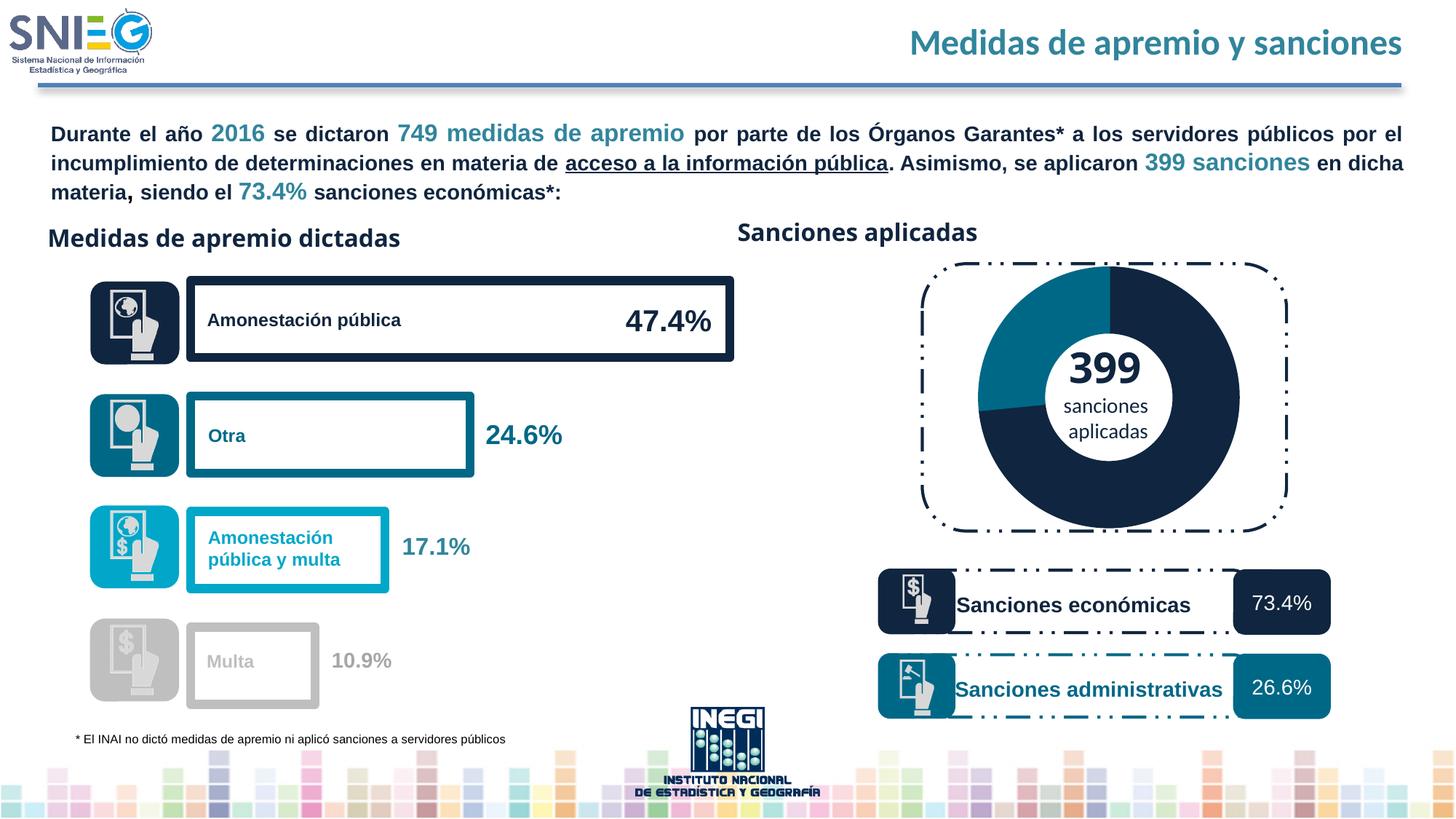
What kind of chart is 'Medidas de apremio dictadas'? Bar chart In the 'Medidas de apremio dictadas' chart, what is the difference between Amonestación pública and Otra? 22.8% In the 'Medidas de apremio dictadas' chart, what is the value for Multa? 10.9% How many categories does the 'Medidas de apremio dictadas' chart show? 4 In the 'Medidas de apremio dictadas' chart, which category has the highest value? Amonestación pública In the 'Medidas de apremio dictadas' chart, what is the value for Otra? 24.6% In the 'Medidas de apremio dictadas' chart, what is the value for Amonestación pública? 47.4% What total number is shown in the centre of the 'Sanciones aplicadas' chart? 399 In the 'Medidas de apremio dictadas' chart, which is larger: Amonestación pública y multa or Multa? Amonestación pública y multa In the 'Sanciones aplicadas' chart, what share do Sanciones económicas represent? 73.4% In the 'Sanciones aplicadas' chart, what is the value for Sanciones administrativas? 26.6% In the 'Medidas de apremio dictadas' chart, which category has the lowest value? Multa